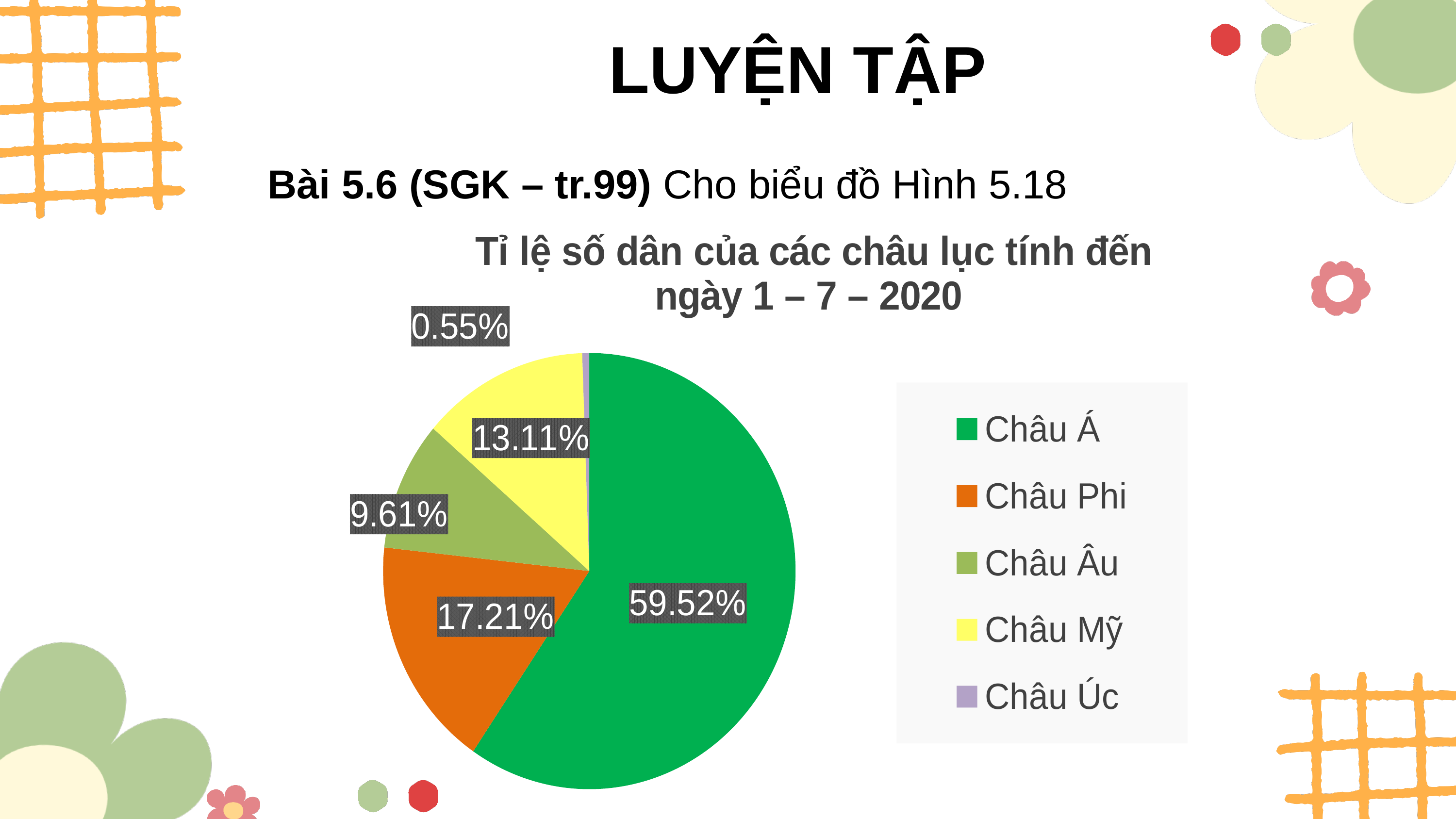
Which continent has the largest share of the pie? Châu Á What is the value shown for Châu Á? 59.52% What is the value shown for Châu Úc? 0.55% What is the value shown for Châu Mỹ? 13.11% What is the value shown for Châu Âu? 9.61% What is the value shown for Châu Phi? 17.21% How many slices does the pie chart have? 5 What is the title of the pie chart? Tỉ lệ số dân của các châu lục tính đến ngày 1 – 7 – 2020 Which continent has the smallest share of the pie? Châu Úc Which is larger, the value for Châu Mỹ or the value for Châu Âu? Châu Mỹ What kind of chart is shown on the slide? Pie chart What is the difference between the values for Châu Phi and Châu Mỹ? 4.10%